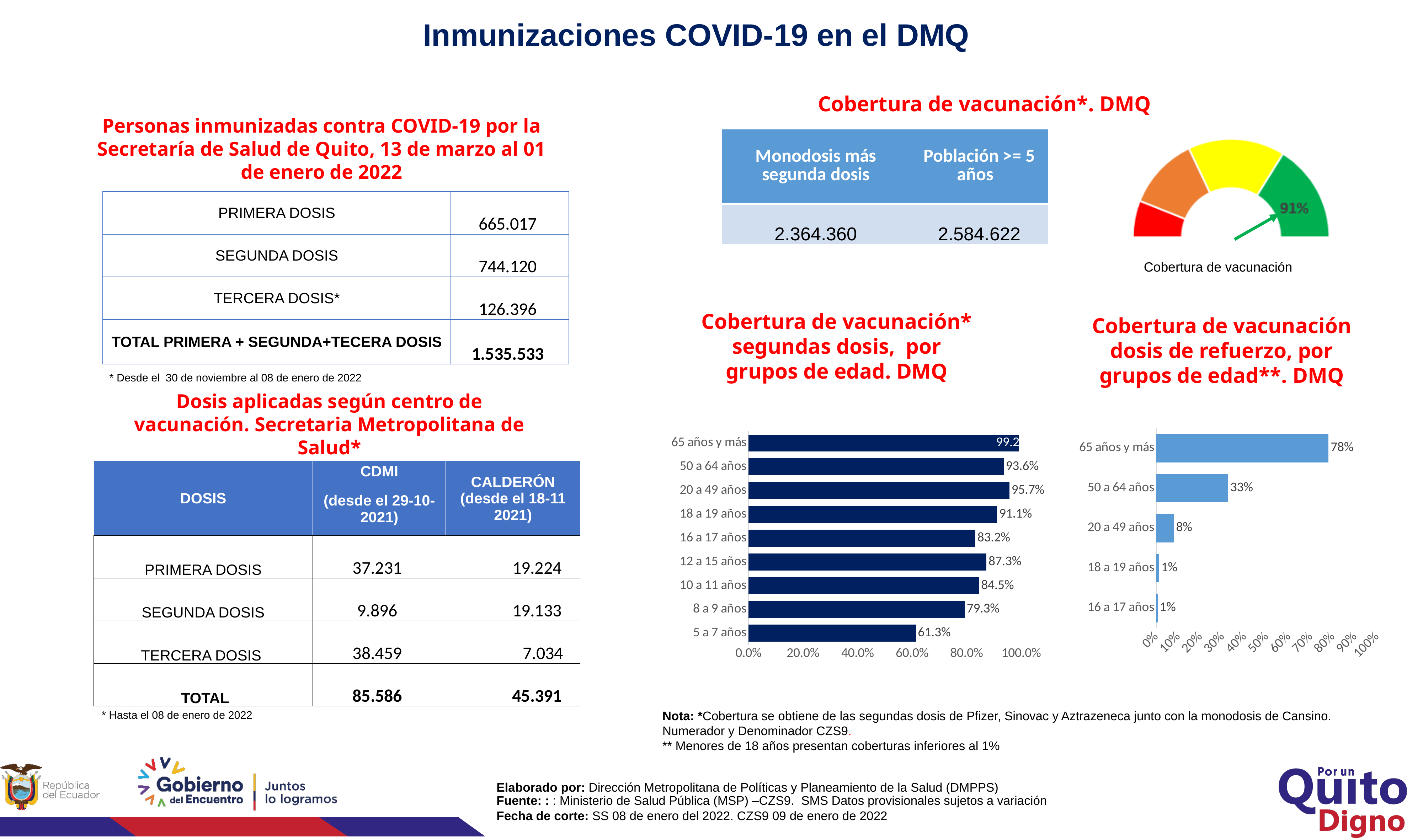
In the chart 'Cobertura de vacunación* segundas dosis, por grupos de edad. DMQ', which age group has the highest coverage? 65 años y más How many age groups are shown in the chart 'Cobertura de vacunación* segundas dosis, por grupos de edad. DMQ'? 9 In the chart 'Cobertura de vacunación* segundas dosis, por grupos de edad. DMQ', which age group has the lowest coverage? 5 a 7 años In the chart 'Cobertura de vacunación* segundas dosis, por grupos de edad. DMQ', what is the value for '5 a 7 años'? 61.3% In the chart 'Cobertura de vacunación* segundas dosis, por grupos de edad. DMQ', what is the difference between the values for '12 a 15 años' and '8 a 9 años'? 8.0% In the chart 'Cobertura de vacunación dosis de refuerzo, por grupos de edad**. DMQ', what is the difference between the values for '65 años y más' and '20 a 49 años'? 70% What kind of chart is 'Cobertura de vacunación dosis de refuerzo, por grupos de edad**. DMQ'? Bar chart In the chart 'Cobertura de vacunación* segundas dosis, por grupos de edad. DMQ', which is larger, the value for '16 a 17 años' or '10 a 11 años'? 10 a 11 años In the chart 'Cobertura de vacunación dosis de refuerzo, por grupos de edad**. DMQ', what is the value for '50 a 64 años'? 33% In the chart 'Cobertura de vacunación dosis de refuerzo, por grupos de edad**. DMQ', what is the value for '65 años y más'? 78% How many age groups are shown in the chart 'Cobertura de vacunación dosis de refuerzo, por grupos de edad**. DMQ'? 5 In the chart 'Cobertura de vacunación* segundas dosis, por grupos de edad. DMQ', what is the value for '20 a 49 años'? 95.7%